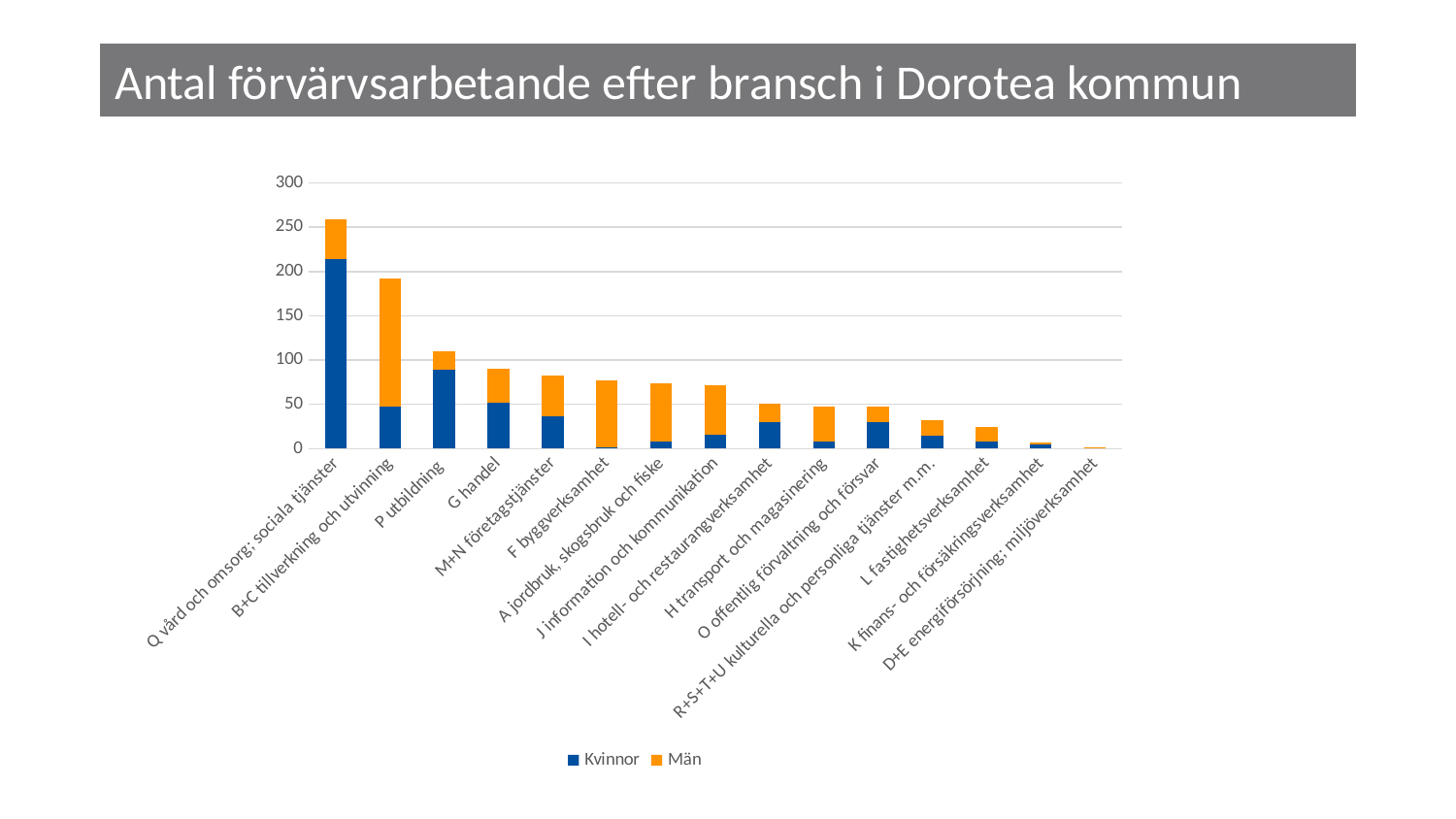
Which category has the lowest total bar? D+E energiförsörjning; miljöverksamhet Which category has the highest total bar? Q vård och omsorg; sociala tjänster Which has the larger total bar, P utbildning or G handel? P utbildning How many industry categories are shown on the x axis? 15 Is the total value for B+C tillverkning och utvinning greater or less than 200? less Is the total value for P utbildning greater or less than 100? greater What kind of chart is shown on the slide? Stacked bar chart Do the total bar values rise or fall moving from left to right along the x axis? fall Is the total value for Q vård och omsorg; sociala tjänster greater or less than 250? greater Which two series are listed in the legend? Kvinnor and Män How many series does the legend list? 2